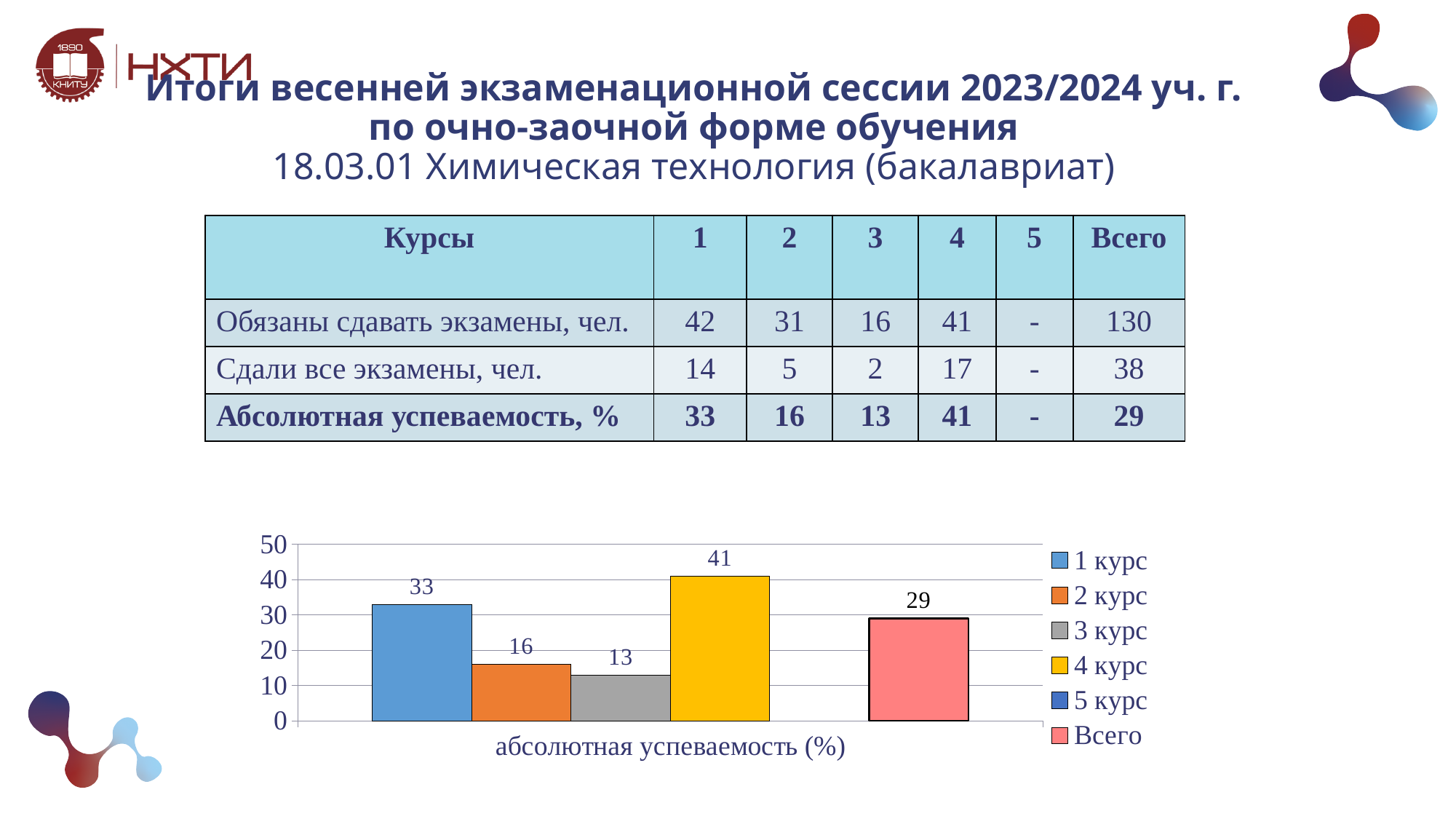
What is the difference between the values for 4 курс and 2 курс? 25 What is the value for Всего in the chart? 29 Which is larger, the value for 1 курс or the value for Всего? 1 курс Which series has the highest value in the chart? 4 курс What is the x-axis category label of the chart? абсолютная успеваемость (%) How many series does the legend list? 6 What kind of chart is shown on the slide? bar chart Is the value for 2 курс greater or less than 20? less What colour is the bar for 4 курс? yellow What is the value for 4 курс in the chart? 41 Which series has the lowest plotted value in the chart? 3 курс What is the value for 1 курс in the chart? 33